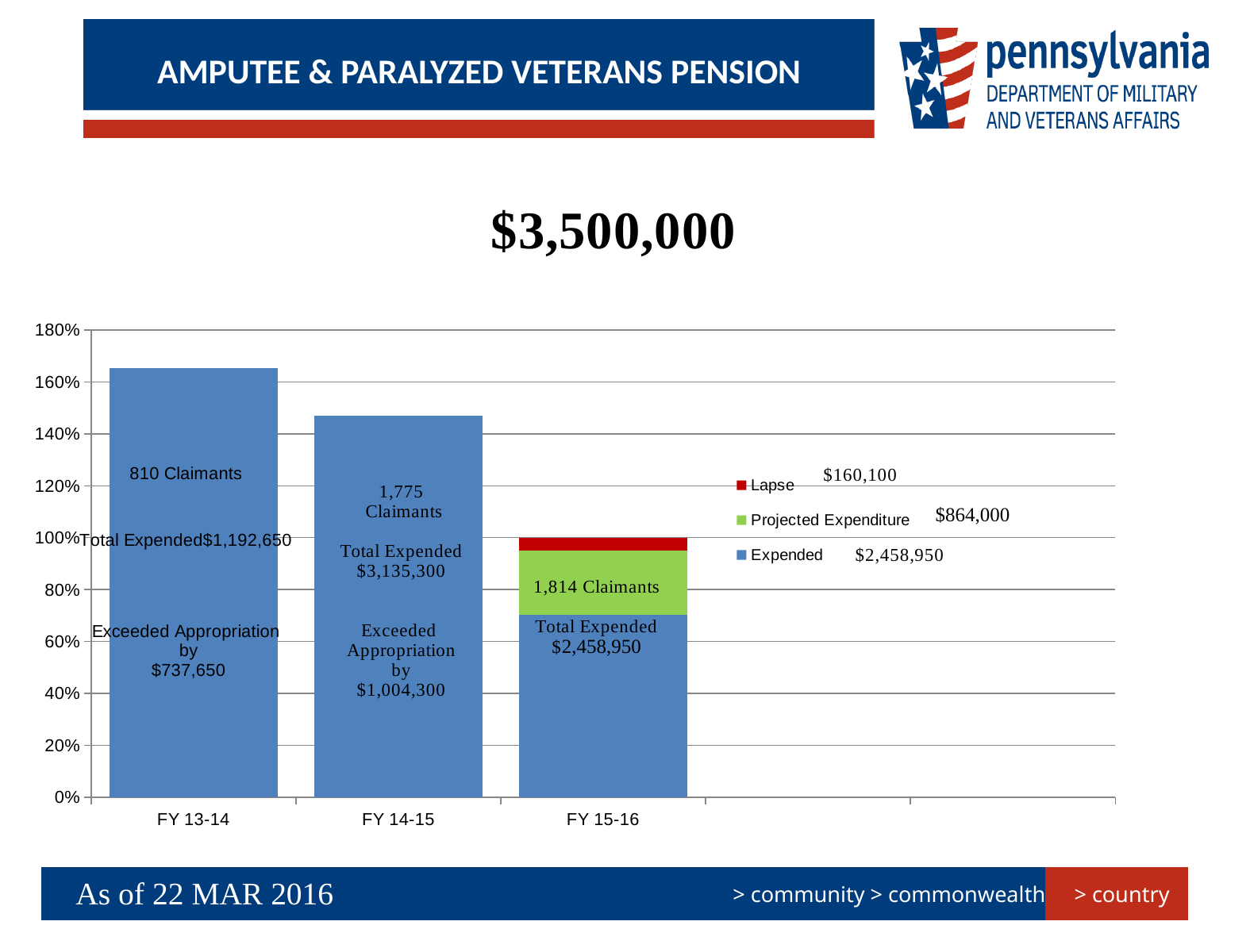
Which fiscal year has the tallest bar? FY 13-14 What is the Total Expended for FY 14-15? $3,135,300 What value is shown next to Lapse in the legend? $160,100 What is the difference between the Total Expended in FY 14-15 and in FY 13-14? $1,942,650 By how much was the appropriation exceeded in FY 13-14? $737,650 Is the bar for FY 14-15 greater or less than 140%? greater How many fiscal years are shown on the x axis of the chart? 3 How many claimants are shown for FY 15-16? 1,814 Claimants What kind of chart is shown on the slide? bar chart Which fiscal year had more claimants, FY 14-15 or FY 15-16? FY 15-16 What value is shown next to Projected Expenditure in the legend? $864,000 How many series does the chart's legend list? 3